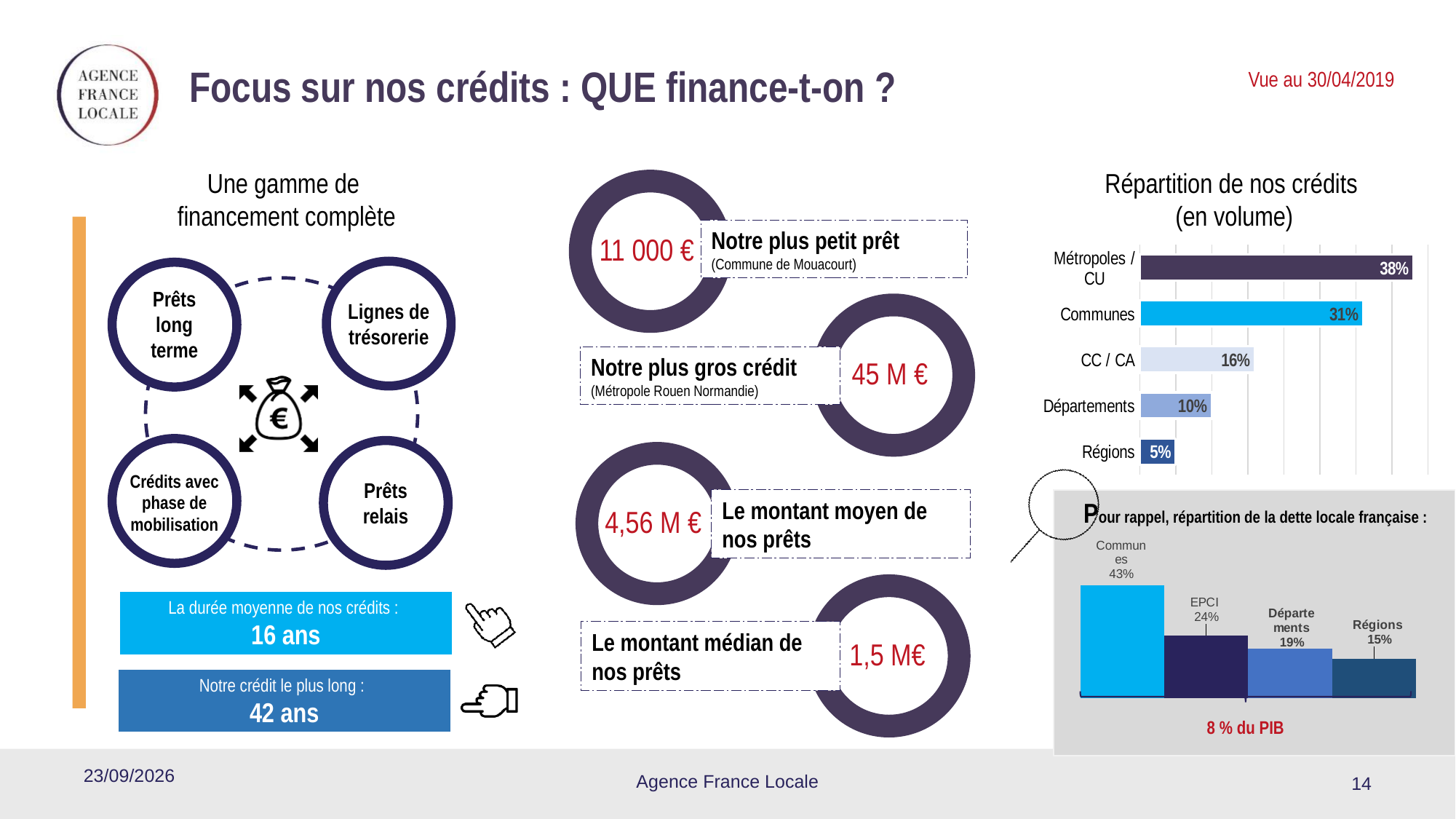
In the 'Répartition de nos crédits (en volume)' chart, what is the difference between Métropoles / CU and Communes? 7% In the 'Pour rappel, répartition de la dette locale française' chart, what is the difference between Départements and Régions? 4% In the 'Répartition de nos crédits (en volume)' chart, which category has the lowest value? Régions What type of chart is 'Répartition de nos crédits (en volume)'? Bar chart In the 'Répartition de nos crédits (en volume)' chart, which category has the highest value? Métropoles / CU How many categories are shown in the 'Répartition de nos crédits (en volume)' chart? 5 In the 'Pour rappel, répartition de la dette locale française' chart, which category has the highest value? Communes In the 'Pour rappel, répartition de la dette locale française' chart, what is the value for EPCI? 24% In the 'Répartition de nos crédits (en volume)' chart, what is the value for Communes? 31% In the 'Répartition de nos crédits (en volume)' chart, which is larger: Départements or CC / CA? CC / CA How many categories are shown in the 'Pour rappel, répartition de la dette locale française' chart? 4 In the 'Répartition de nos crédits (en volume)' chart, what is the value for CC / CA? 16%